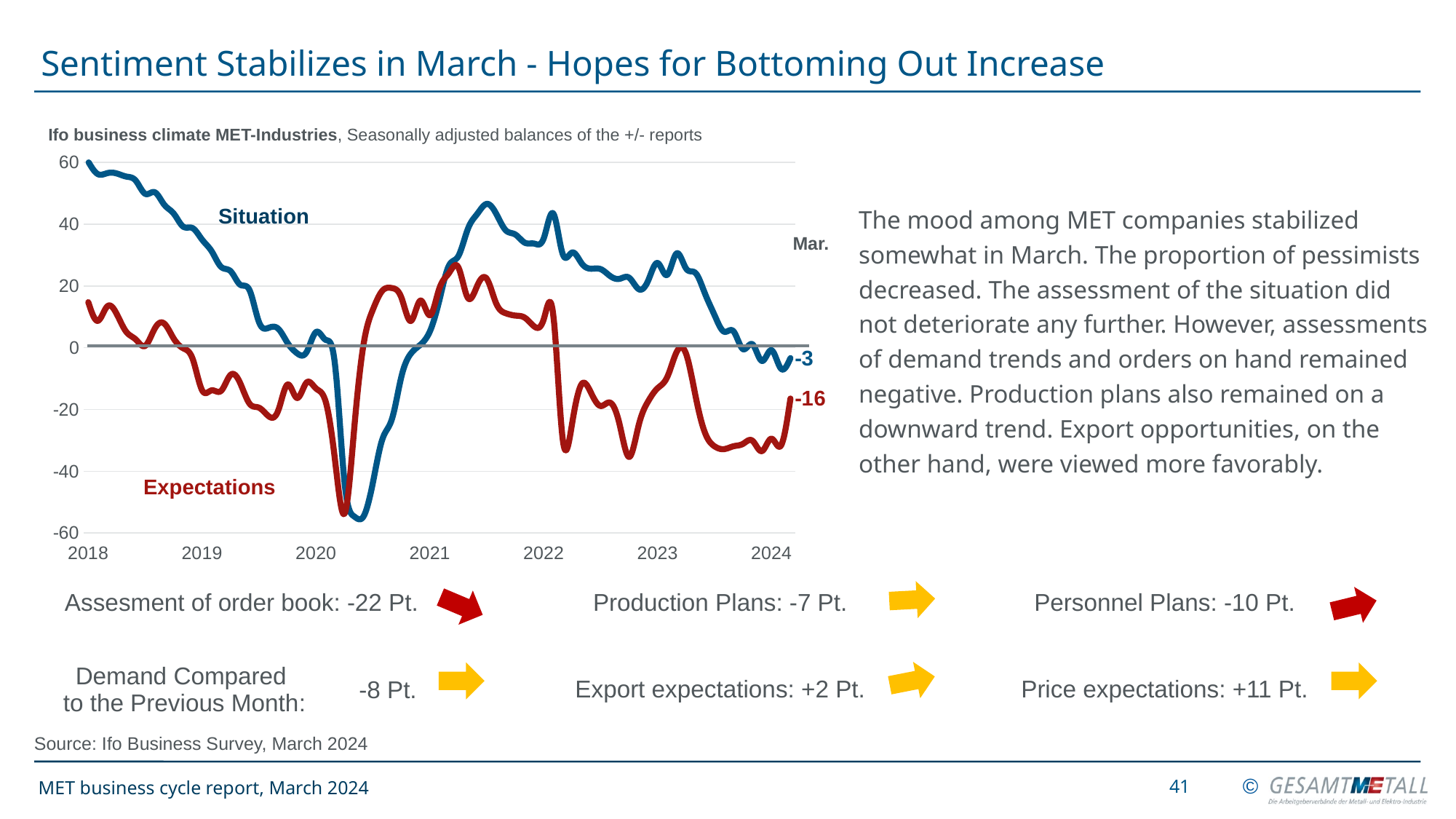
What is the difference between the latest Situation value and the latest Expectations value? 13 Does the Situation series rise or fall between the start of 2018 and the end of 2019? fall What is the latest (Mar.) value of the Expectations series? -16 What colour is the Expectations line? red What type of chart is shown on the slide? line chart What is the latest (Mar.) value of the Situation series? -3 At the latest data point, which series is higher: Situation or Expectations? Situation How many series are plotted in the Ifo business climate chart? 2 How many year labels are shown on the x axis? 7 Is the Expectations value at the start of 2018 greater or less than 20? less Is the lowest Situation value in 2020 greater or less than -40? less Is the Situation value at the start of 2018 greater or less than 40? greater